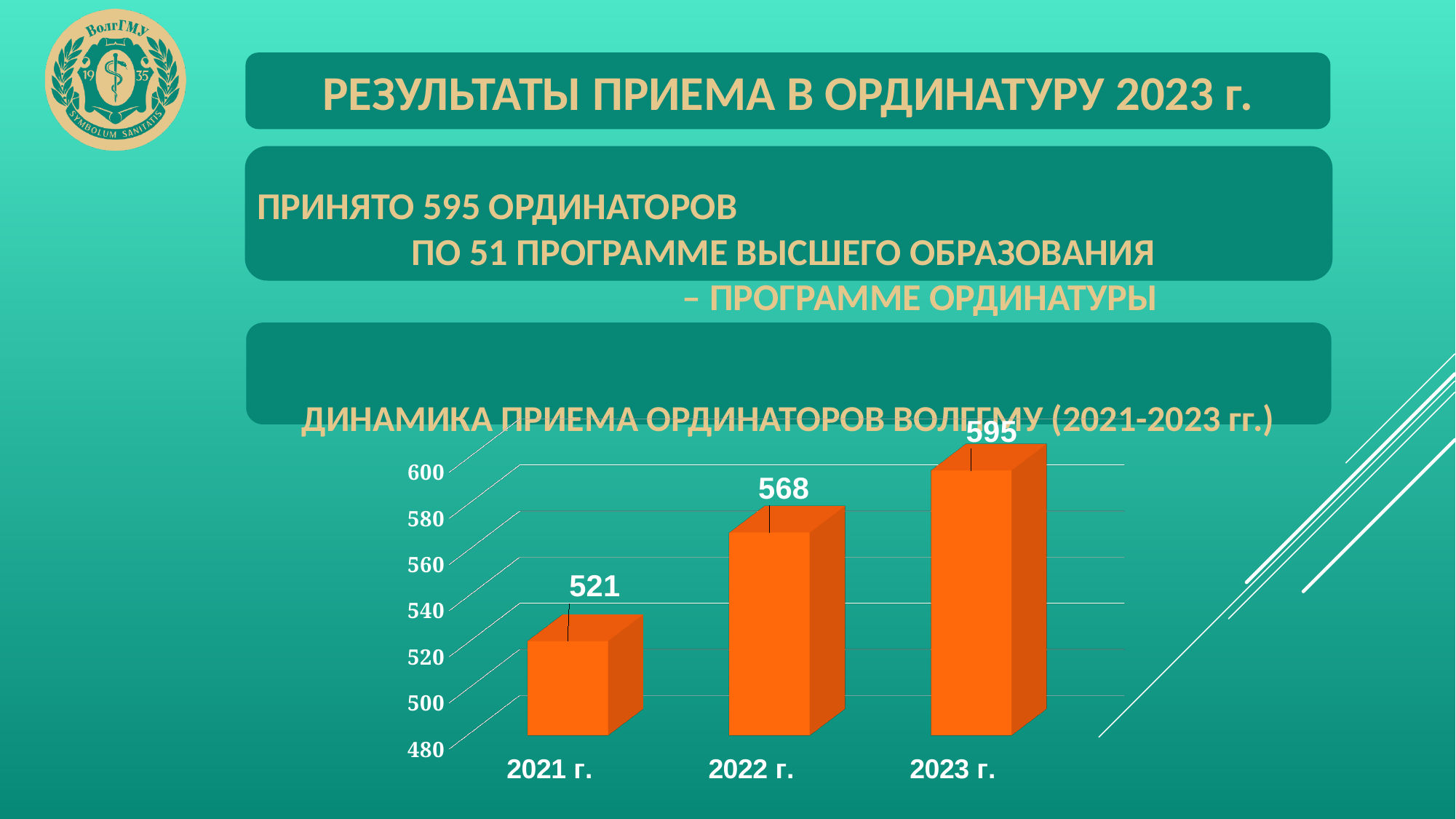
Is the value for 2021 г. greater or less than 540? less Do the values rise or fall from 2021 г. to 2023 г.? rise What is the difference between the values for 2023 г. and 2021 г.? 74 How many years are shown on the x axis? 3 What is the value for 2022 г.? 568 What is the value for 2023 г.? 595 What is the difference between the values for 2022 г. and 2021 г.? 47 Which is larger, the value for 2022 г. or the value for 2023 г.? 2023 г. What is the value for 2021 г.? 521 Which year has the lowest value? 2021 г. What kind of chart is shown on the slide? bar chart Which year has the highest value? 2023 г.